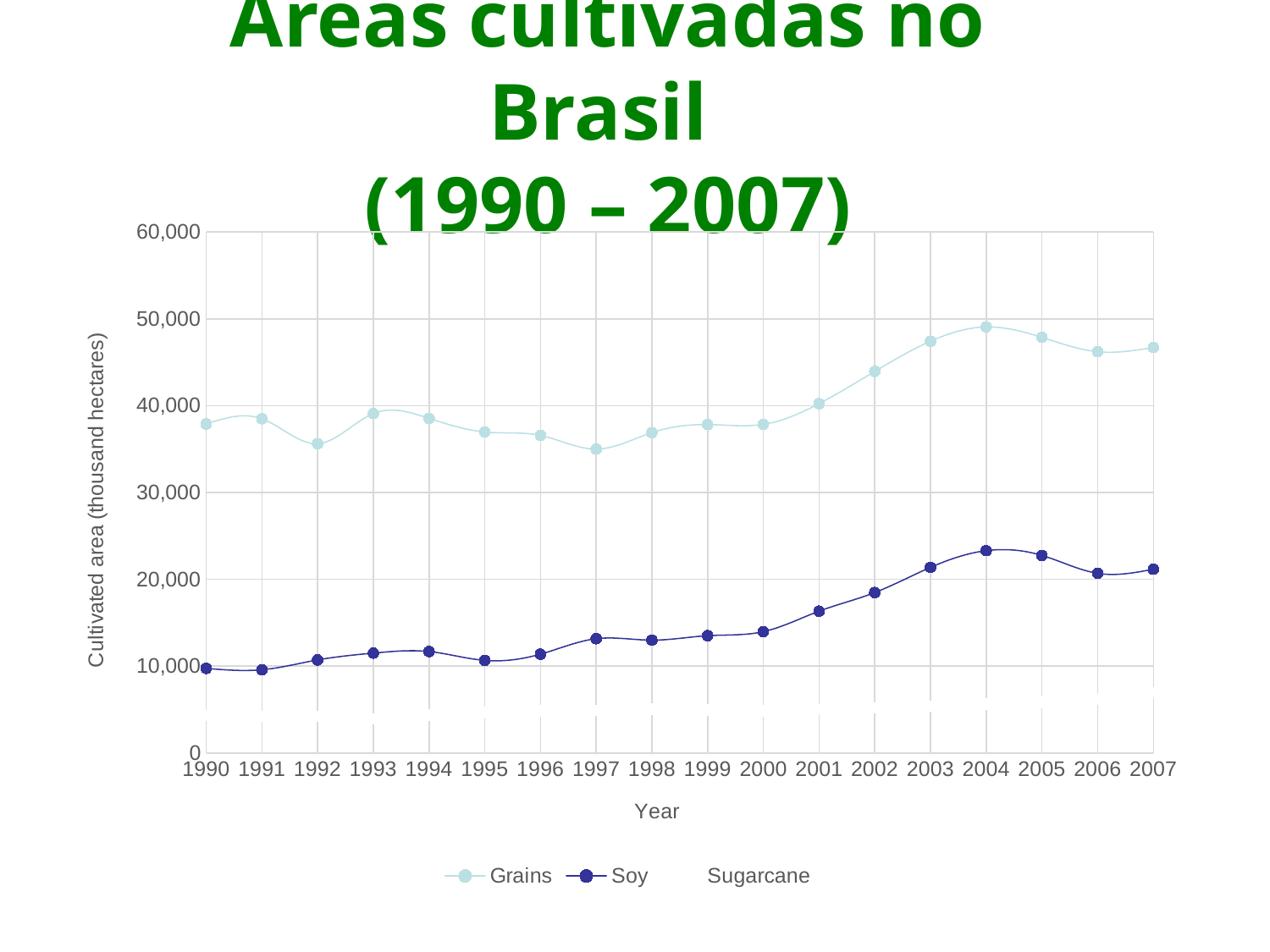
In which year does the Soy series reach its highest value? 2004 Is the value for Grains in 2004 greater or less than 40,000? greater Does the Soy series rise or fall between 2000 and 2004? rise What kind of chart is shown on the slide? line chart How many series does the legend list? 3 In which year does the Grains series reach its highest value? 2004 How many years are plotted along the x axis? 18 Is the value for Grains in 1997 greater or less than 40,000? less Is the value for Soy in 2004 greater or less than 20,000? greater In 2000, which series has the larger value, Grains or Soy? Grains What is the label of the y axis? Cultivated area (thousand hectares)